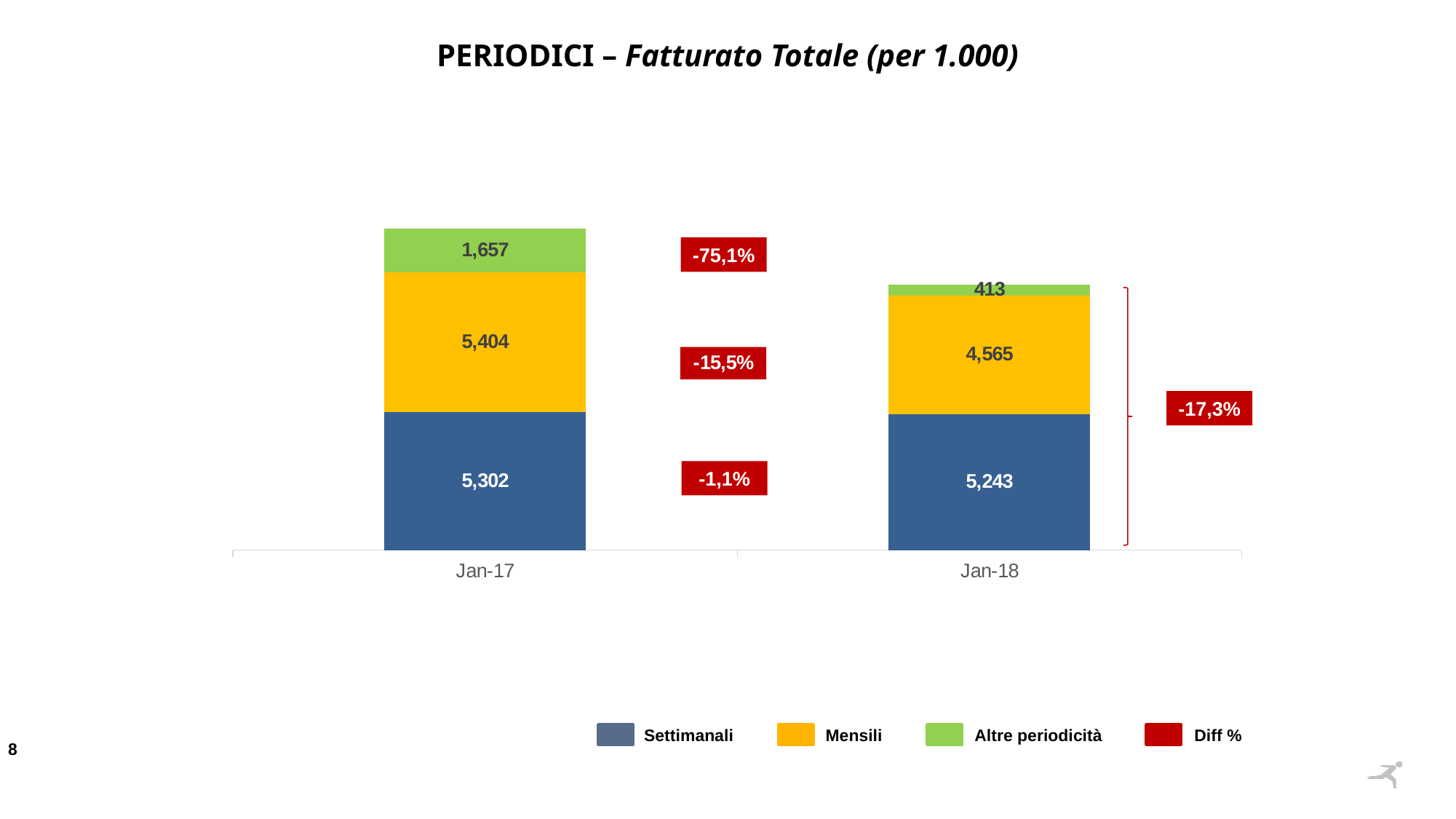
What is the total of the Jan-18 stacked bar (Settimanali, Mensili and Altre periodicità)? 10,221 What is the overall Diff % shown next to the Jan-18 bar? -17,3% What is the value for Settimanali in Jan-17? 5,302 Which is larger, Altre periodicità in Jan-17 or Altre periodicità in Jan-18? Jan-17 Which segment of the Jan-18 bar has the lowest value? Altre periodicità What kind of chart is shown on the slide? Stacked bar chart What is the Diff % shown for Altre periodicità? -75,1% Which segment of the Jan-17 bar has the highest value? Mensili How many entries does the legend list? 4 What is the value for Mensili in Jan-18? 4,565 What is the value for Altre periodicità in Jan-17? 1,657 What is the difference between the Mensili values for Jan-17 and Jan-18? 839